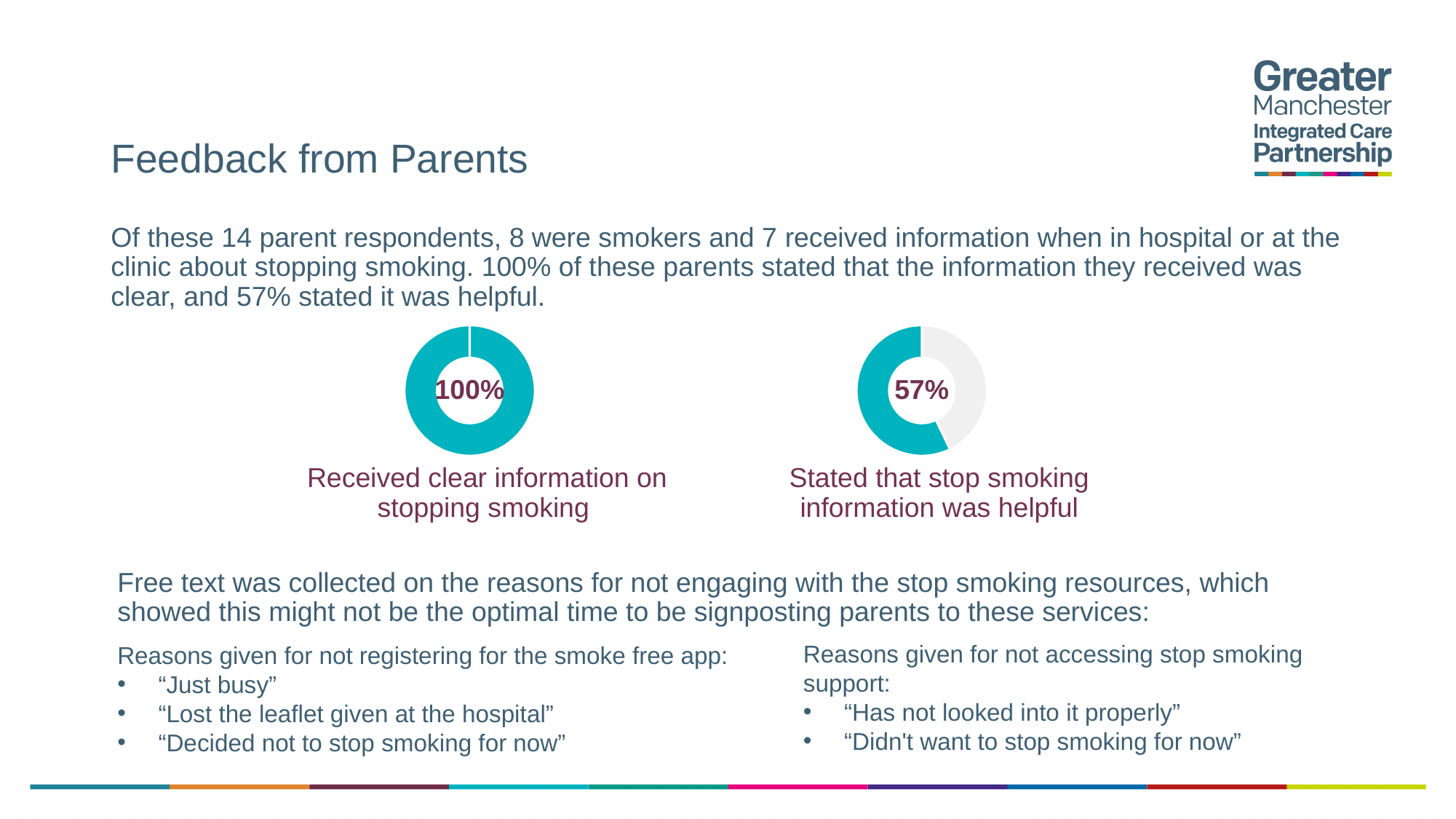
Is the value shown on the right donut chart (information was helpful) greater or less than 50%? greater How many donut charts are shown on the slide? 2 Which is larger: the share of parents who received clear information on stopping smoking, or the share who stated the information was helpful? Received clear information on stopping smoking What is the label beneath the left donut chart? Received clear information on stopping smoking On the left donut chart, what percentage of parents received clear information on stopping smoking? 100% What colour is the filled portion of the donut charts? Teal On the right donut chart, what percentage of parents stated that stop smoking information was helpful? 57% On the right donut chart, what share of the ring is left unfilled (grey)? 43% What is the difference in percentage points between the left chart (received clear information) and the right chart (information was helpful)? 43% What kind of chart is used to show the 100% and 57% figures on the slide? Donut chart